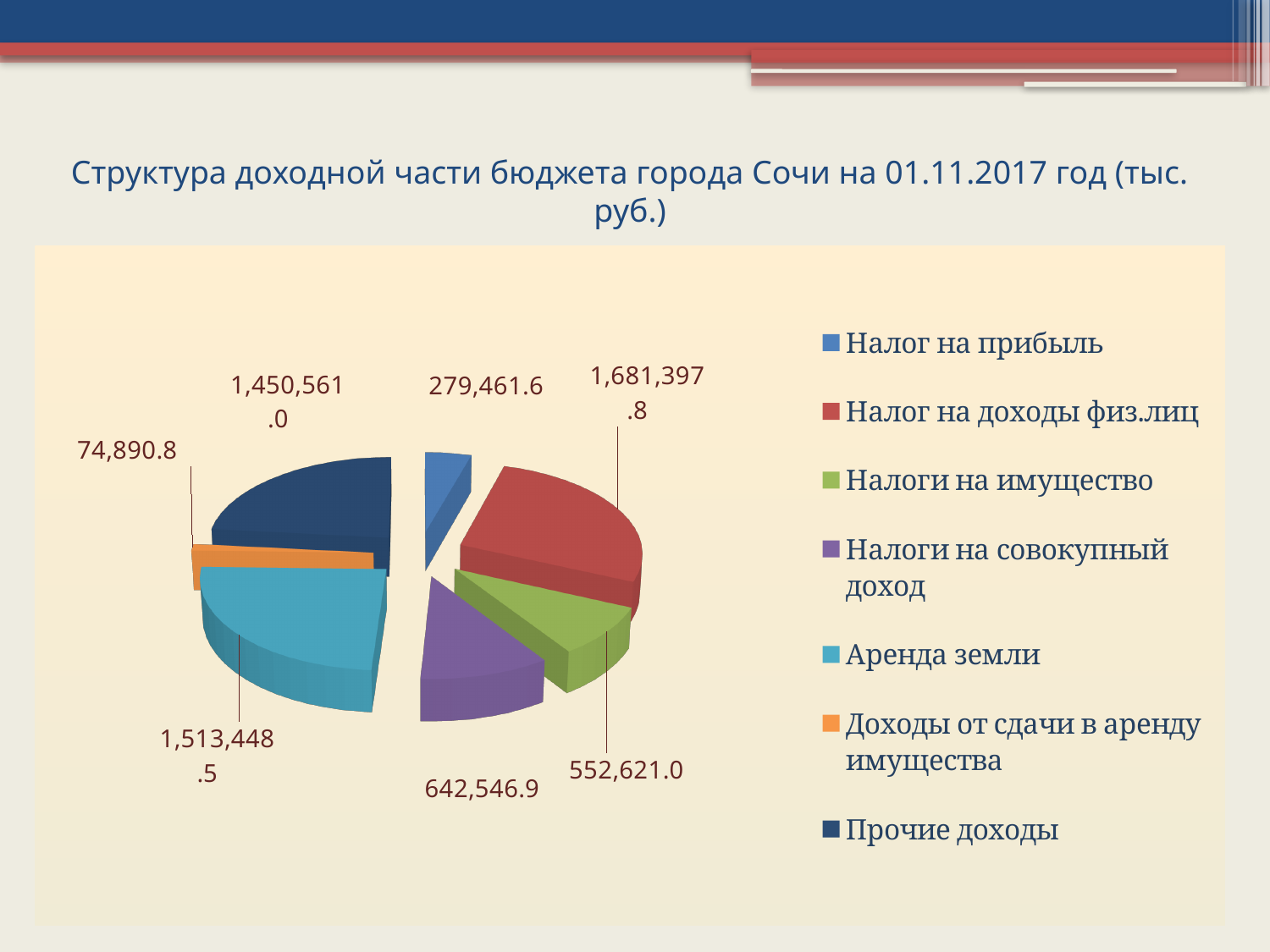
Which category has the smallest slice of the pie? Доходы от сдачи в аренду имущества What is the value for Налог на доходы физ.лиц? 1,681,397.8 What kind of chart is shown on the slide? Pie chart What is the difference between Налог на доходы физ.лиц and Аренда земли? 167,949.3 What is the value for Аренда земли? 1,513,448.5 Which is larger, Аренда земли or Прочие доходы? Аренда земли What is the value for Доходы от сдачи в аренду имущества? 74,890.8 Which category has the largest slice of the pie? Налог на доходы физ.лиц How many categories does the legend list? 7 What is the difference between Налоги на совокупный доход and Налоги на имущество? 89,925.9 What is the value for Налоги на совокупный доход? 642,546.9 What is the value for Прочие доходы? 1,450,561.0